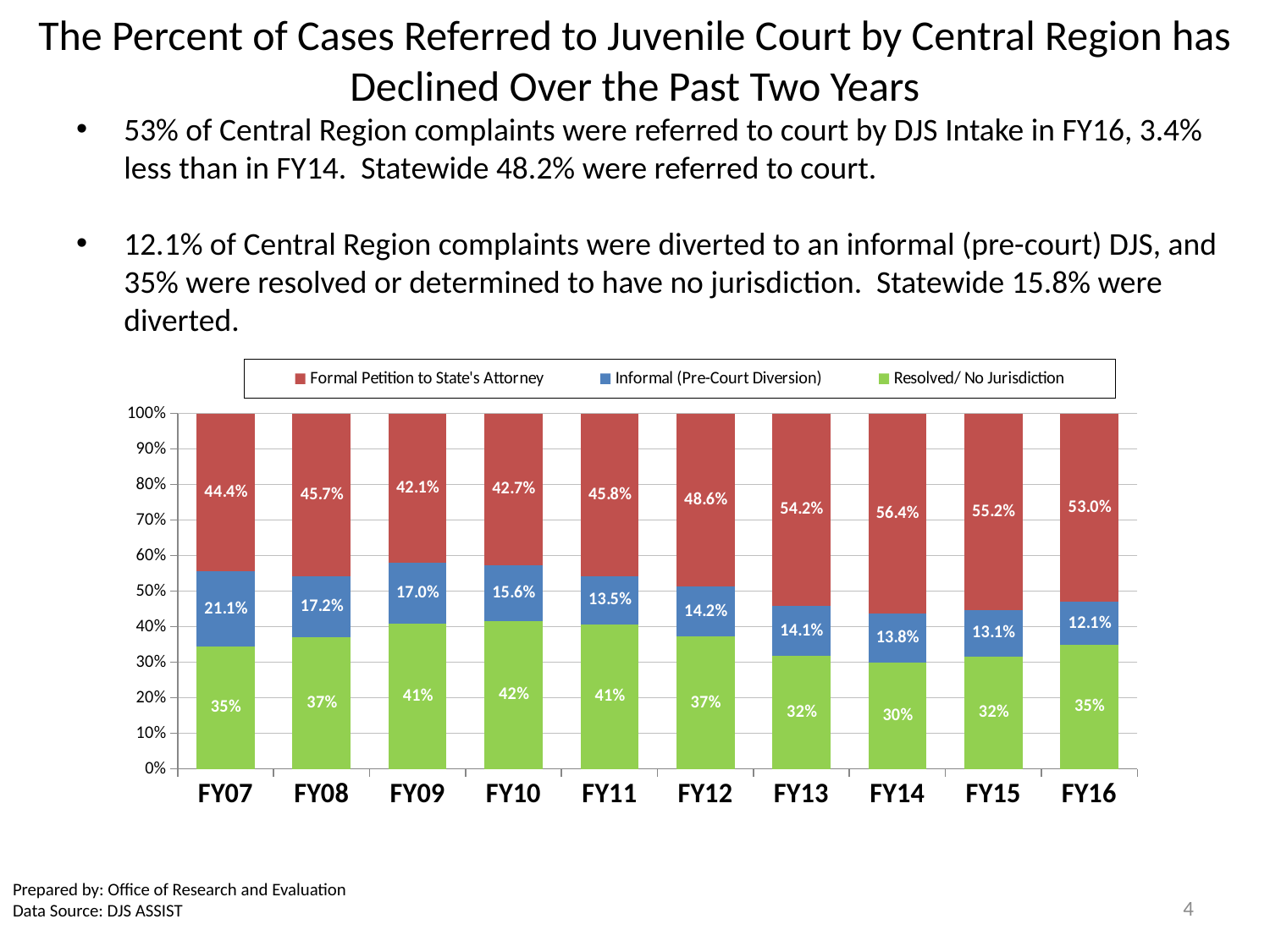
What percentage of cases were Informal (Pre-Court Diversion) in FY07? 21.1% Which is larger, the Resolved/ No Jurisdiction share in FY09 or in FY13? FY09 What percentage of cases were a Formal Petition to State's Attorney in FY16? 53.0% In which fiscal year was the Informal (Pre-Court Diversion) share lowest? FY16 How many series does the legend list? 3 Which colour represents Resolved/ No Jurisdiction in the chart? Green In which fiscal year was the Formal Petition to State's Attorney share highest? FY14 What kind of chart is shown on the slide? Stacked bar chart What percentage of cases were Resolved/ No Jurisdiction in FY10? 42% Does the Informal (Pre-Court Diversion) share generally rise or fall from FY07 to FY16? Fall How many fiscal years are shown on the x axis? 10 What is the difference between the Formal Petition to State's Attorney share in FY14 and in FY16? 3.4%